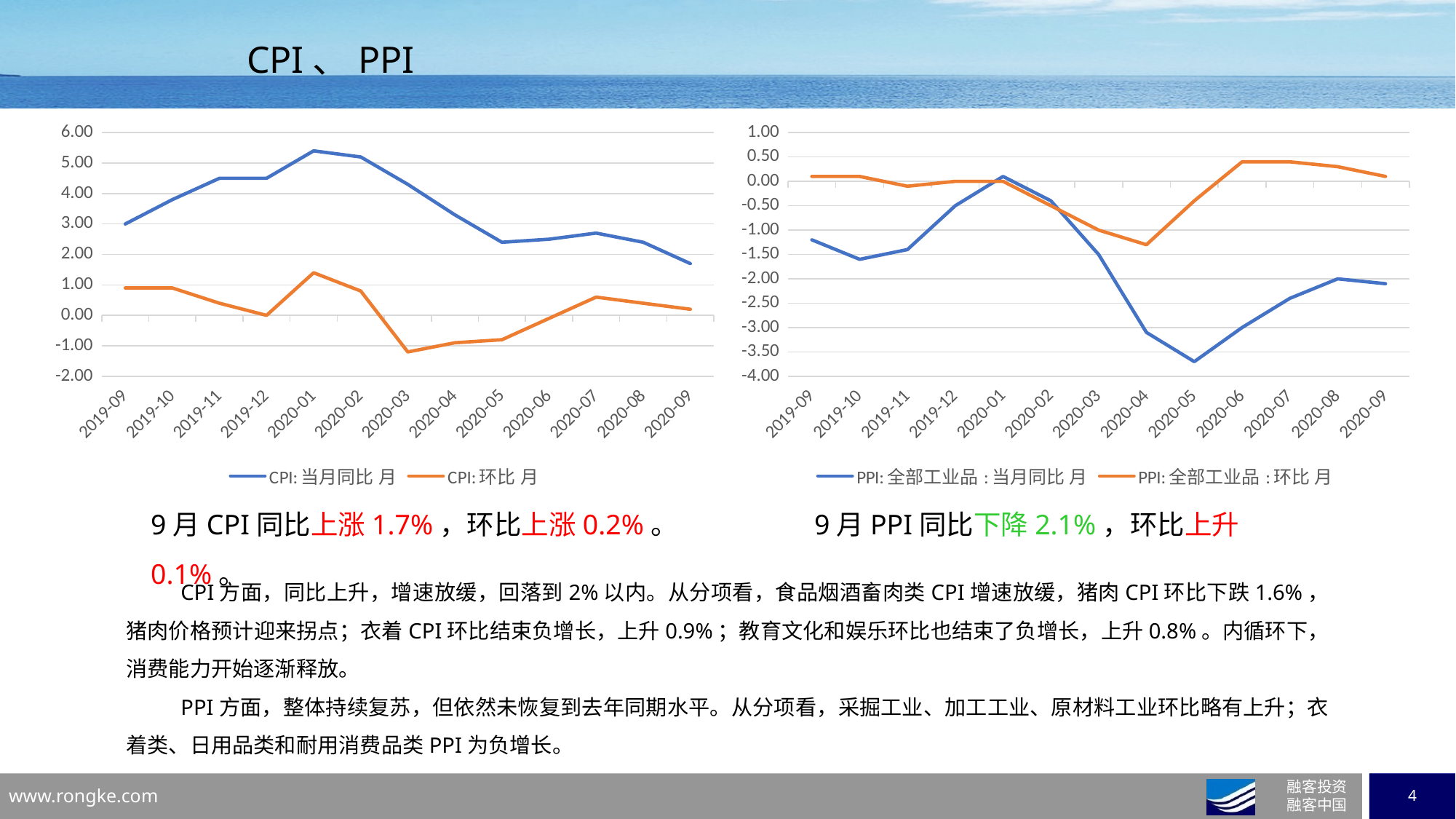
In the left chart (CPI), in which month does the CPI 环比 series reach its lowest value? 2020-03 In the left chart (CPI), is the value of CPI 当月同比 for 2020-01 greater or less than 5.00? greater In the right chart (PPI), does the PPI 全部工业品:当月同比 series rise or fall from 2020-05 to 2020-09? rise What type of chart is the left chart (CPI)? line chart How many series does the legend of the right chart (PPI) list? 2 In the right chart (PPI), is the value of PPI 全部工业品:当月同比 for 2020-05 greater or less than -3.50? less In the left chart (CPI), does the CPI 当月同比 series generally rise or fall from 2020-01 to 2020-09? fall In the right chart (PPI), in which month does the PPI 全部工业品:当月同比 series reach its lowest value? 2020-05 In the left chart (CPI), in which month does the CPI 当月同比 series reach its highest value? 2020-01 How many months are plotted along the x axis of the left chart (CPI)? 13 In the right chart (PPI), in which month does the PPI 全部工业品:环比 series reach its lowest value? 2020-04 In the left chart (CPI), which is larger for CPI 当月同比: the value for 2020-02 or the value for 2020-05? 2020-02